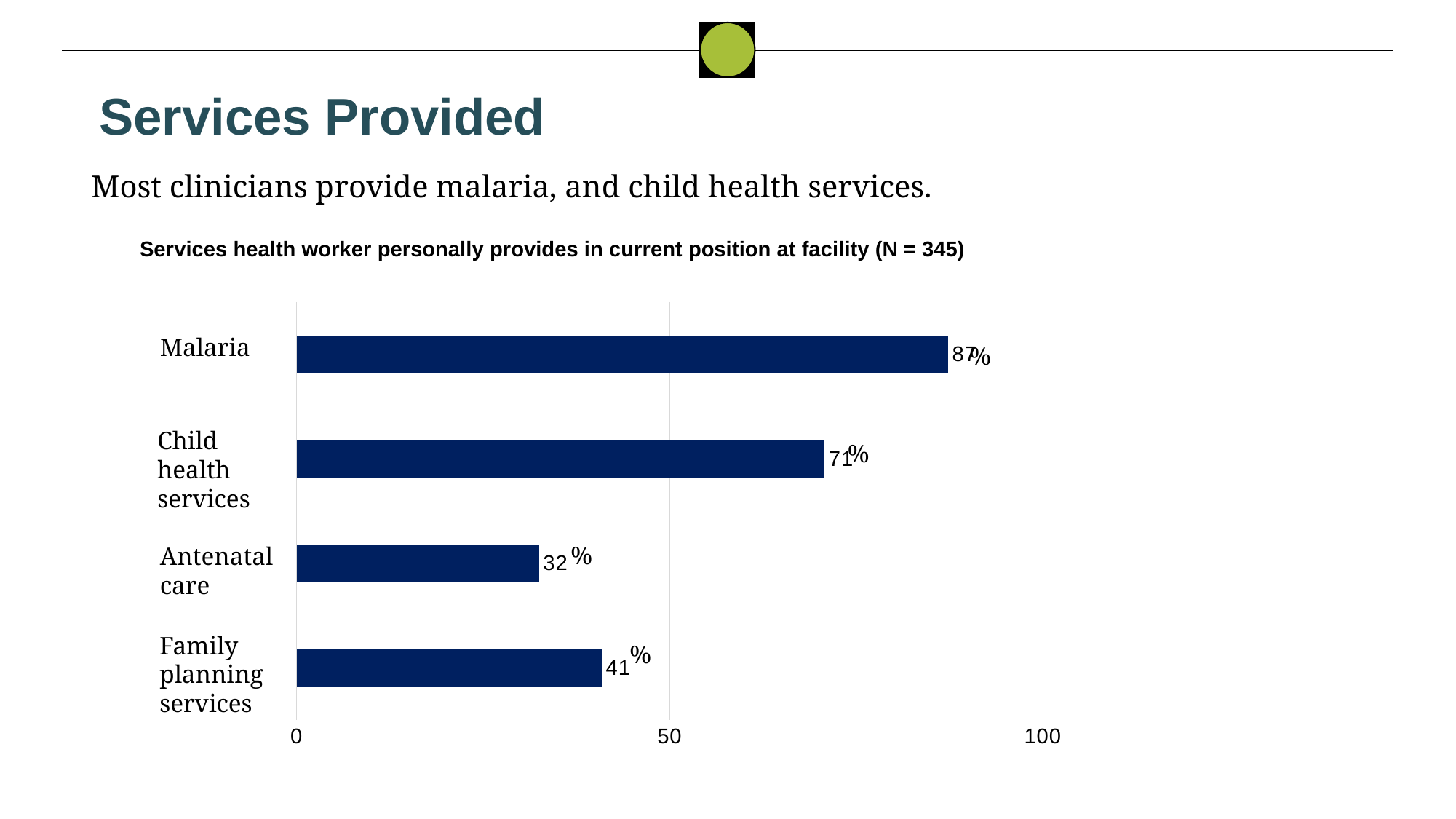
Which is larger, the value for antenatal care or the value for family planning services? Family planning services What percentage of health workers personally provide child health services? 71% How many services are shown in the chart? 4 What kind of chart is shown on the slide? Bar chart What is the difference in percentage points between family planning services and antenatal care? 9 What percentage of health workers personally provide malaria services? 87% What is the sample size (N) stated in the chart title? 345 Which service is provided by the lowest percentage of health workers? Antenatal care Which service is provided by the highest percentage of health workers? Malaria What is the difference in percentage points between malaria and child health services? 16 What percentage of health workers personally provide family planning services? 41% What percentage of health workers personally provide antenatal care? 32%